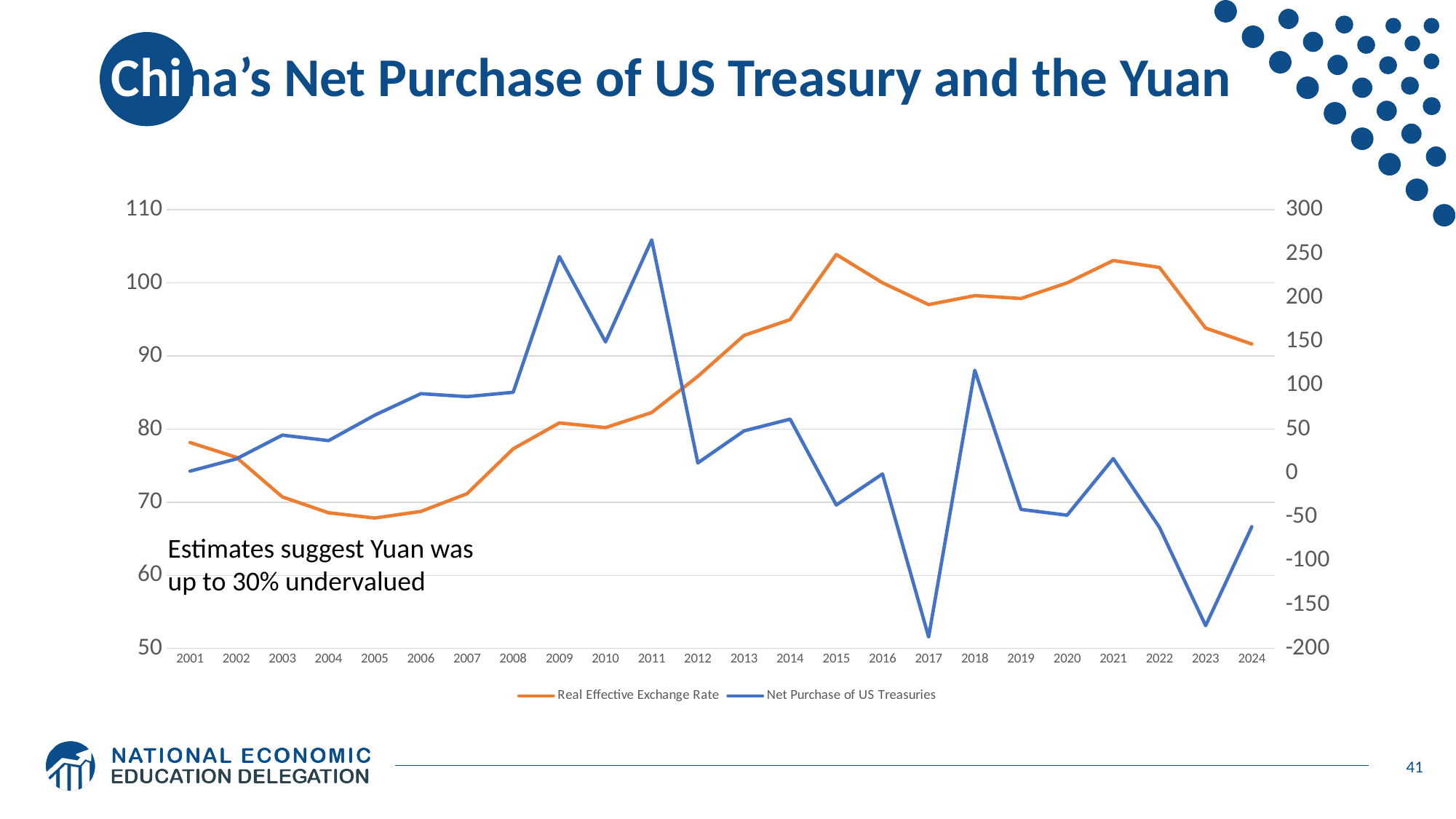
In which year is the Net Purchase of US Treasuries highest? 2011 Is the Net Purchase of US Treasuries in 2011 greater or less than 250? greater Does the Real Effective Exchange Rate rise or fall from 2005 to 2015? rise In which year is the Real Effective Exchange Rate lowest? 2005 What is the title of the chart? China's Net Purchase of US Treasury and the Yuan In which year is the Net Purchase of US Treasuries lowest? 2017 Which is larger, the Real Effective Exchange Rate in 2001 or in 2005? 2001 Which series is drawn in orange? Real Effective Exchange Rate Is the Real Effective Exchange Rate in 2005 greater or less than 70? less What kind of chart is shown on the slide? line chart How many years are plotted along the x axis? 24 How many series does the legend list? 2